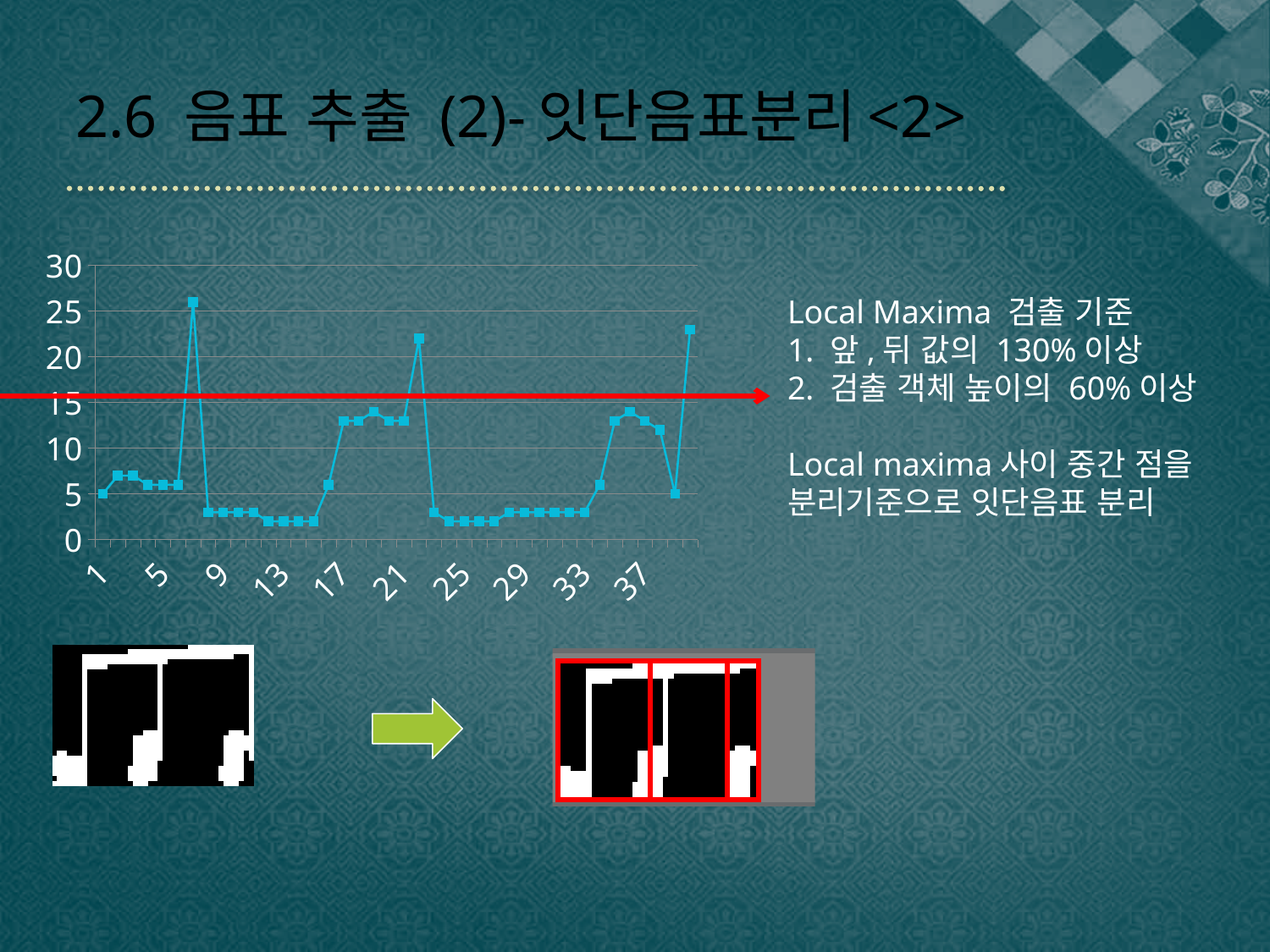
What is the highest value shown on the y-axis? 30 Which has the larger value, the point at x = 7 or the point at x = 22? x = 7 At which x-axis position does the line reach its highest value? 7 Is the value at x = 7 greater or less than 20? greater Is the value at x = 1 greater or less than 10? less Does the line rise or fall between x = 7 and x = 9? fall Is the value at x = 17 greater or less than 10? greater Which has the larger value, the point at x = 1 or the point at x = 7? x = 7 What kind of chart is shown on the slide? line chart